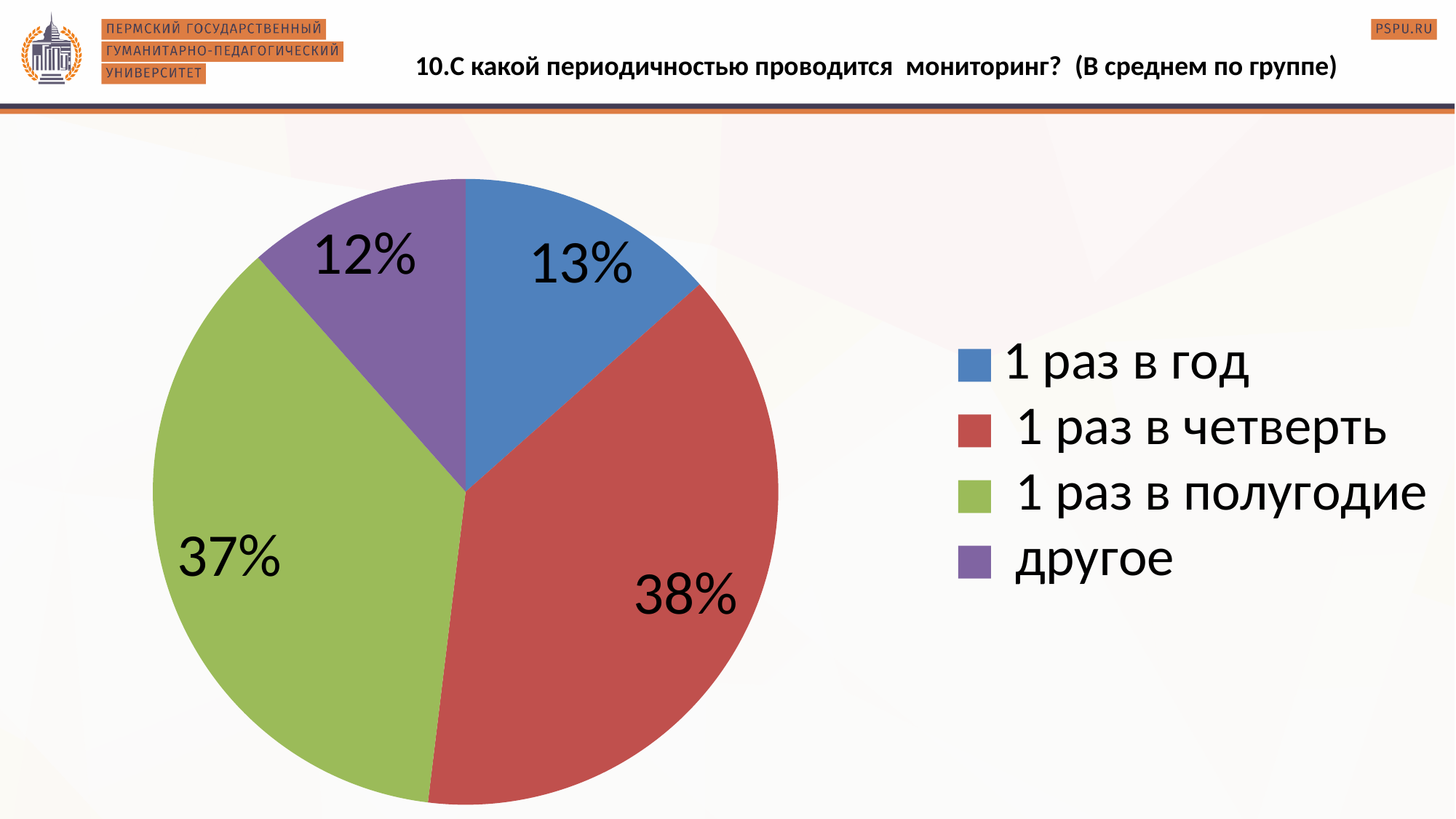
What colour is the slice for "1 раз в полугодие"? green What share of the pie is labelled "1 раз в год"? 13% How many slices does the pie chart have? 4 What is the difference between the shares for "1 раз в четверть" and "1 раз в год"? 25% What share of the pie is labelled "1 раз в полугодие"? 37% What is the combined share of "1 раз в четверть" and "1 раз в полугодие"? 75% Which category has the largest slice of the pie? 1 раз в четверть What share of the pie is labelled "1 раз в четверть"? 38% What kind of chart is shown on the slide? pie chart Which category has the smallest slice of the pie? другое What share of the pie is labelled "другое"? 12% Which is larger: the share for "1 раз в полугодие" or the share for "другое"? 1 раз в полугодие